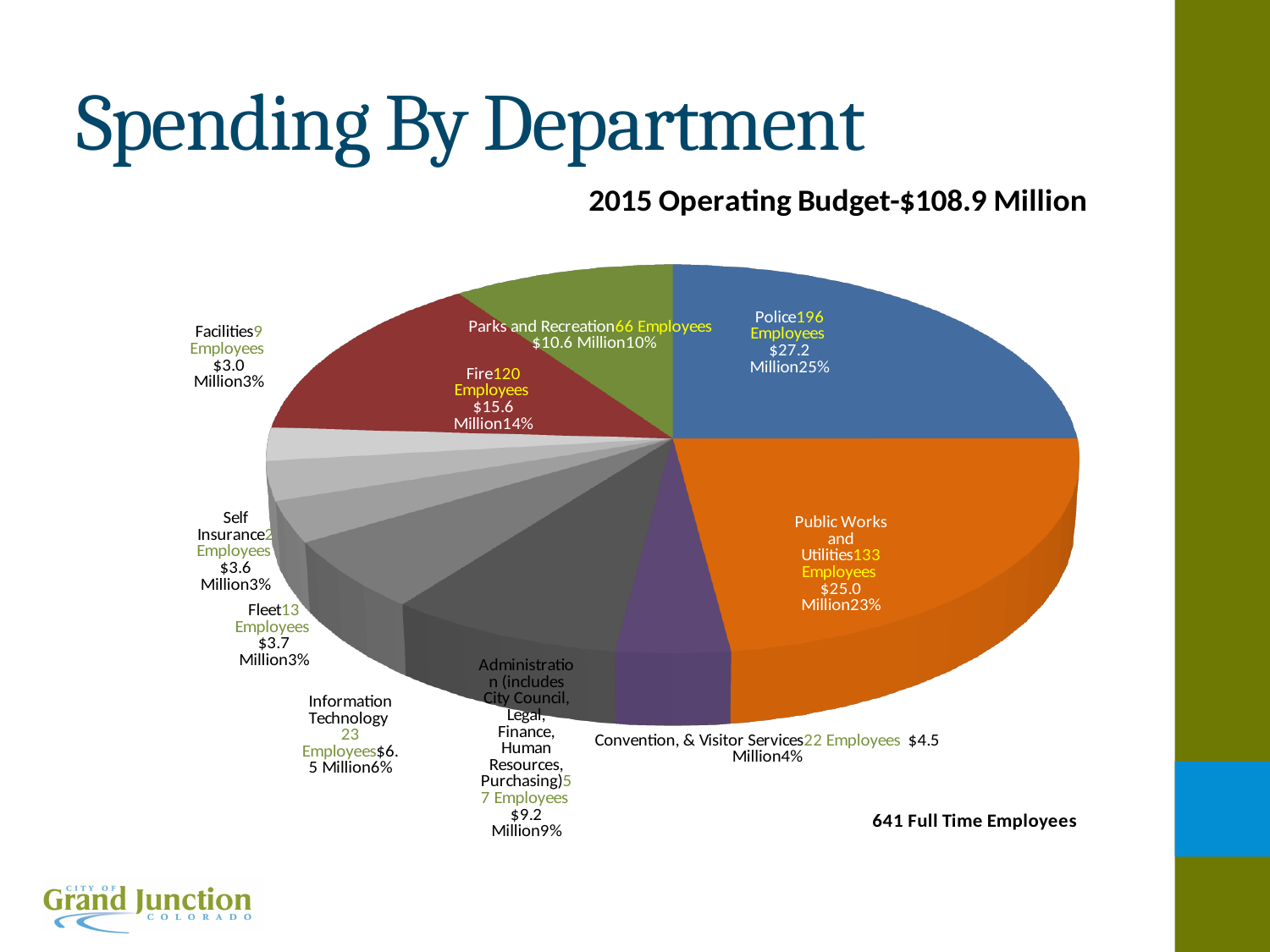
What is the title of the pie chart? 2015 Operating Budget-$108.9 Million What is the spending amount for Police? $27.2 Million What kind of chart is shown on the slide? Pie chart Which department has the largest share of the 2015 operating budget? Police How many full time employees are noted on the slide? 641 Full Time Employees How many employees does Parks and Recreation have? 66 Employees What is the difference in percentage share between Police and Public Works and Utilities? 2% Which is larger, the spending for Fire or for Parks and Recreation? Fire What percentage of the budget goes to Information Technology? 6% What is the spending amount for Fire? $15.6 Million What share of the budget goes to Public Works and Utilities? 23% How many departments are shown in the pie chart? 10